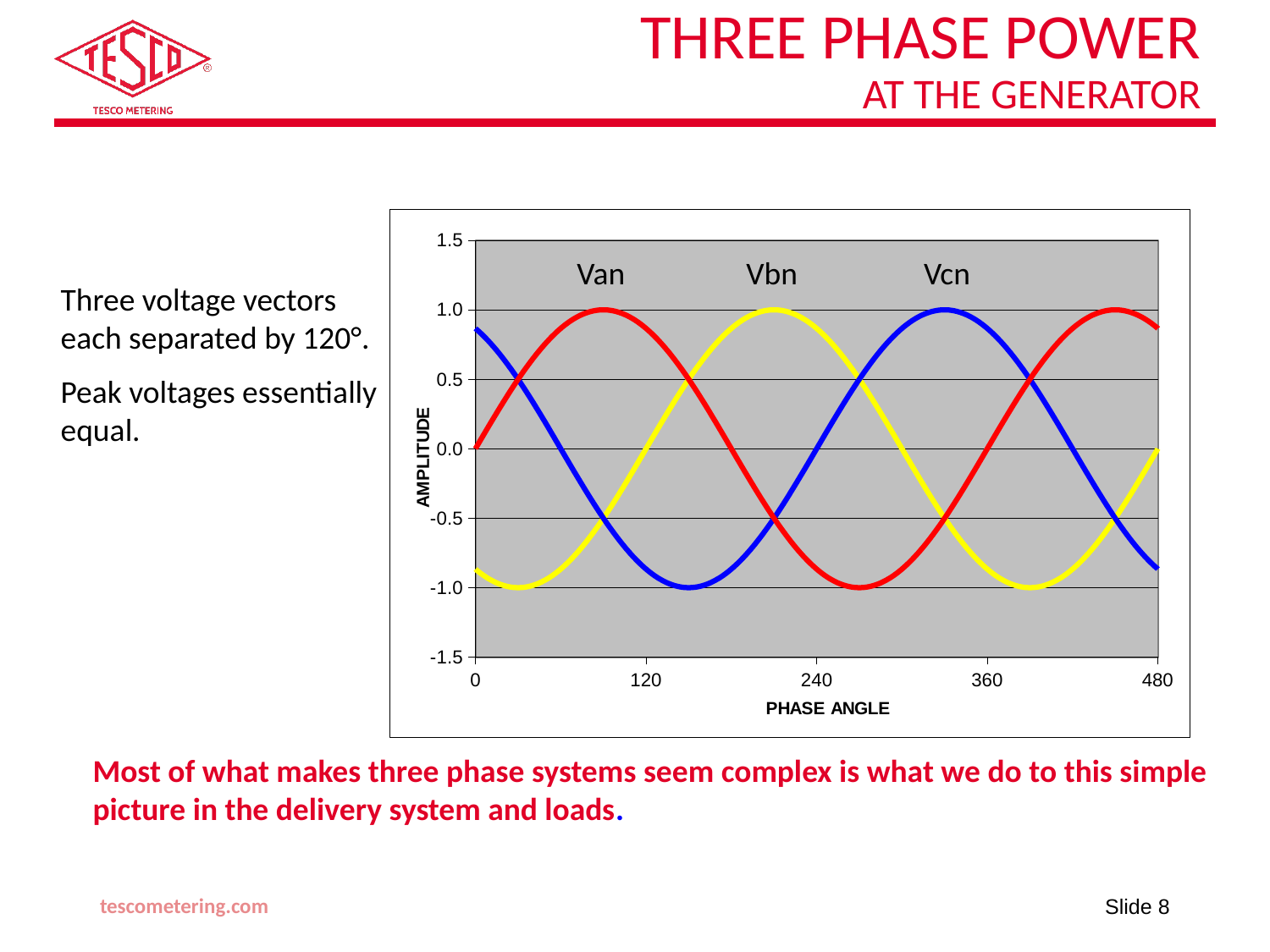
Is the amplitude of Van at a phase angle of 120 greater or less than 0.5? greater Is the amplitude of Van at a phase angle of 240 greater or less than -0.5? less What is the label of the horizontal axis of the chart? PHASE ANGLE Is the amplitude of Vbn at a phase angle of 0 greater or less than -0.5? less What is the lowest amplitude reached by the Vbn curve? -1.0 What is the amplitude of Van at a phase angle of 0? 0.0 What colour is the Vcn curve? blue What kind of chart is shown on the slide? line chart How many voltage series are plotted on the chart? 3 Which series reaches its first peak at the smallest phase angle? Van What is the peak amplitude reached by the Van curve? 1.0